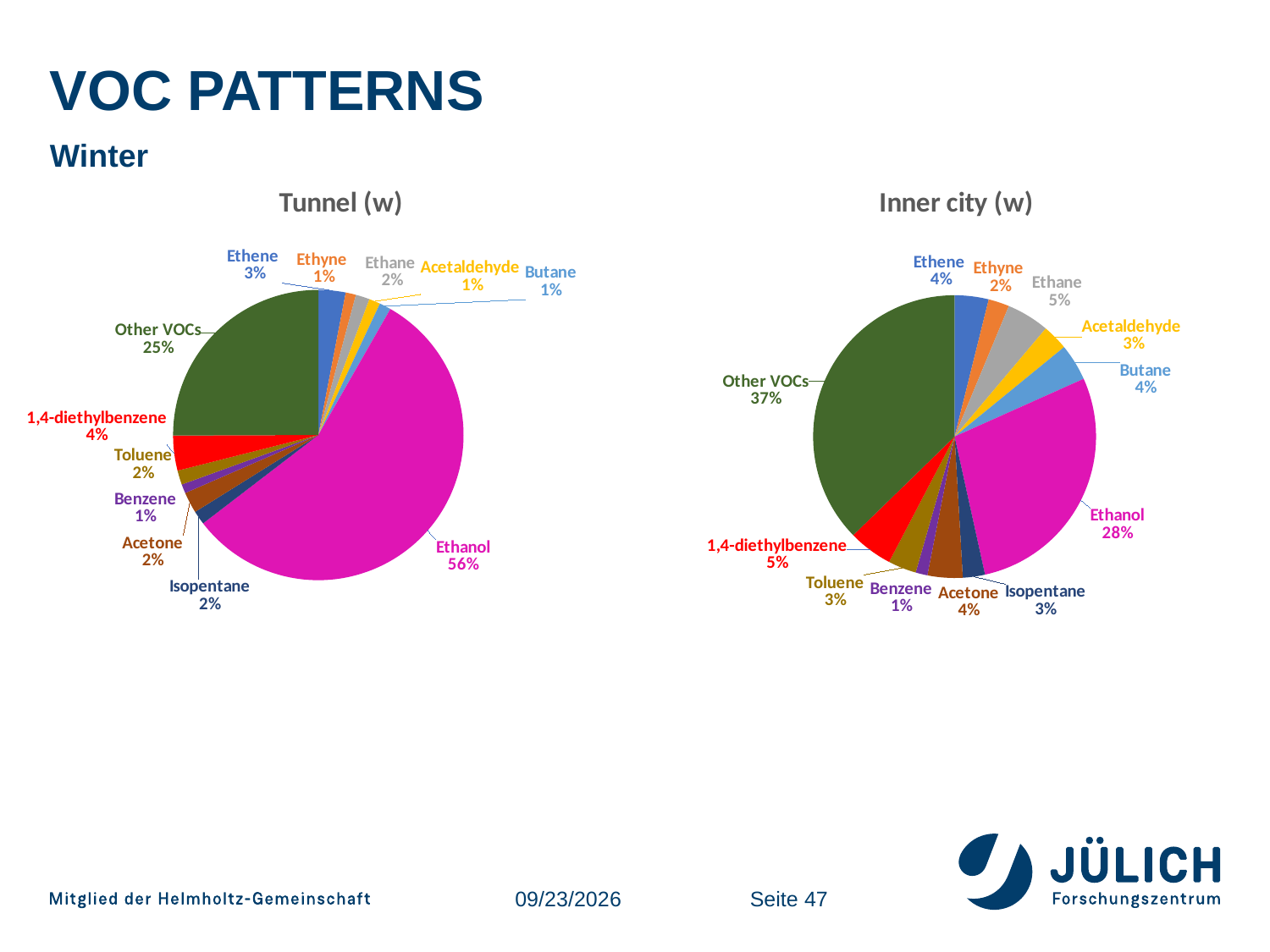
How many slices does the Inner city (w) chart have? 12 In the Inner city (w) chart, what share does Other VOCs have? 37% In the Inner city (w) chart, which category has the smallest slice? Benzene In the Tunnel (w) chart, what share does Ethanol have? 56% In the Tunnel (w) chart, which category has the largest slice? Ethanol What type of chart is the Tunnel (w) chart? Pie chart In the Inner city (w) chart, which is larger, the Ethane slice or the Acetaldehyde slice? Ethane In the Tunnel (w) chart, what share does 1,4-diethylbenzene have? 4% In the Inner city (w) chart, which category has the largest slice? Other VOCs In the Tunnel (w) chart, what is the difference between the Ethanol share and the Other VOCs share? 31% What is the title of the chart on the right side of the slide? Inner city (w) In the Inner city (w) chart, what is the difference between the Other VOCs share and the Ethanol share? 9%